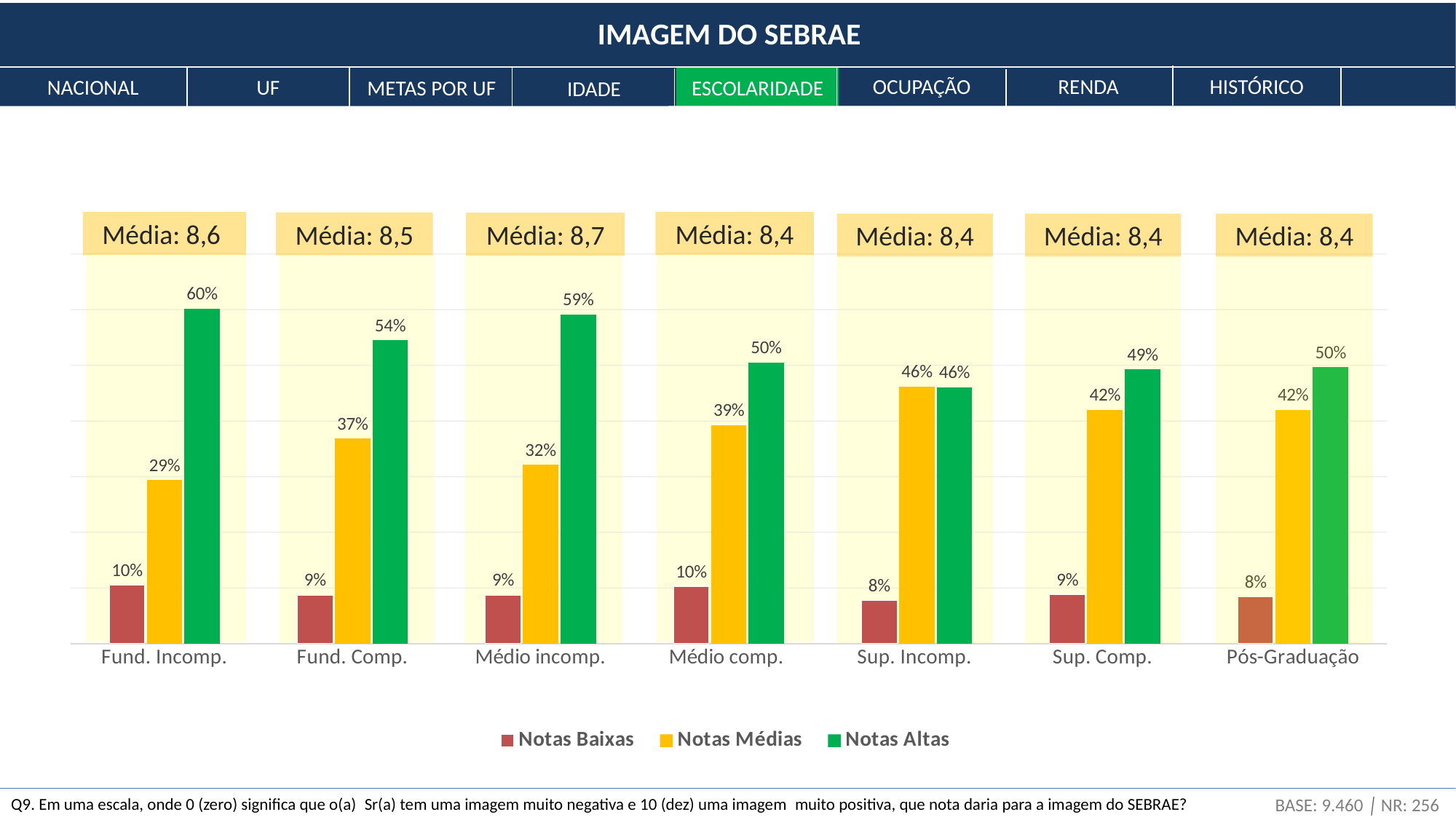
What is the value for Notas Altas in the Fund. Incomp. category? 60% Which is larger in the Pós-Graduação category: Notas Médias or Notas Altas? Notas Altas What is the Média shown above the Médio incomp. category? 8,7 What is the value for Notas Baixas in the Médio comp. category? 10% Which category has the highest value for Notas Altas? Fund. Incomp. What kind of chart is shown on the slide? Bar chart What is the difference between Notas Altas and Notas Médias in the Fund. Comp. category? 17% Which category has the lowest value for Notas Médias? Fund. Incomp. Which series is shown in green in the legend? Notas Altas What is the value for Notas Médias in the Sup. Incomp. category? 46% How many series does the legend list? 3 How many education categories are shown on the x axis? 7